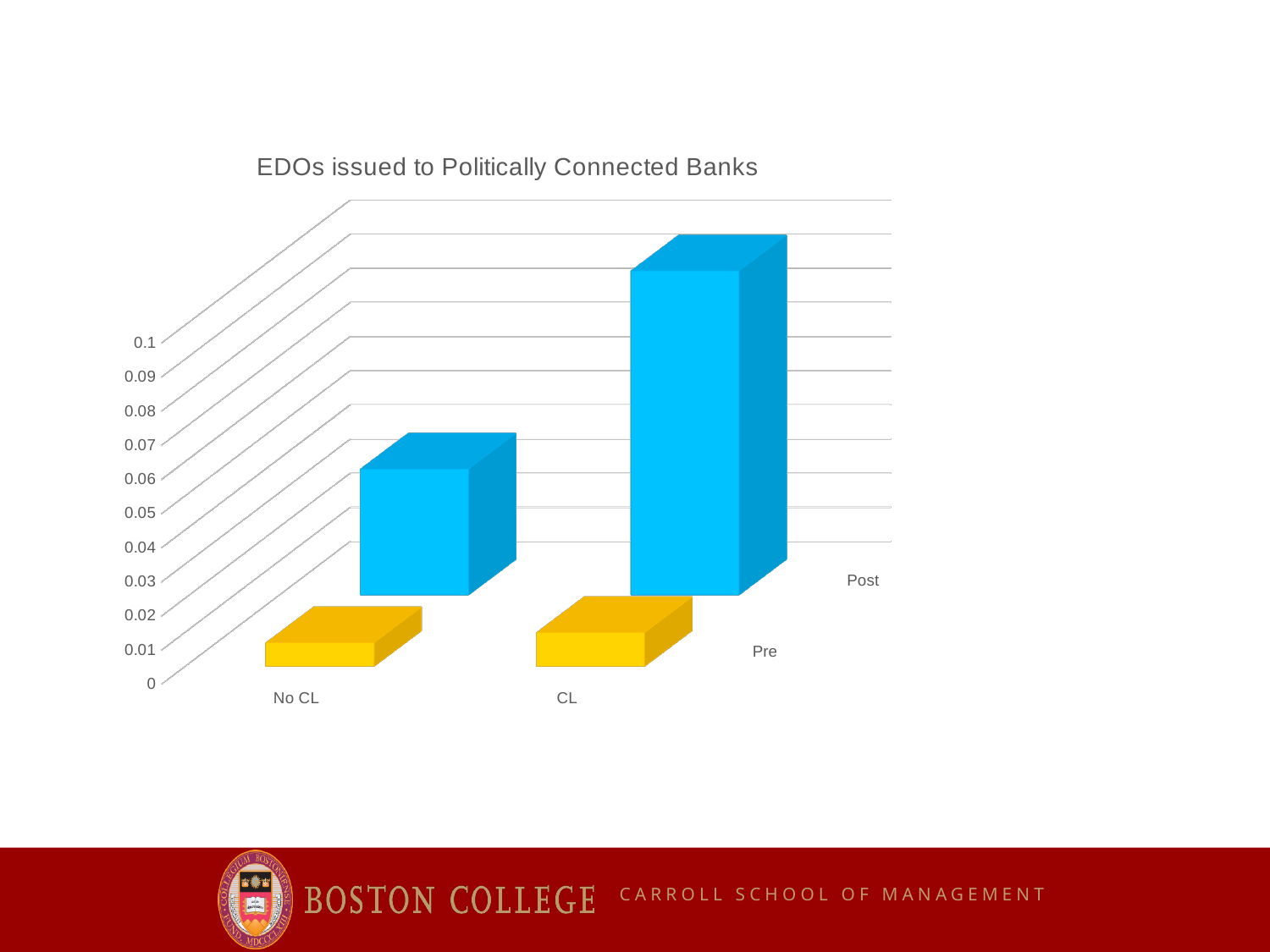
For the Post series, which is larger: No CL or CL? CL Is the Pre value for No CL greater or less than 0.03? less How many categories are shown on the x axis of the chart? 2 What kind of chart is shown on the slide? Bar chart For the No CL category, which is larger: Pre or Post? Post What is the title of the chart? EDOs issued to Politically Connected Banks Which series has the tallest bar in the chart? Post What are the two series shown in the chart? Pre and Post Does the Post series rise or fall from No CL to CL? Rise Which category has the tallest bar in the chart? CL Is the Post value for CL greater or less than 0.05? greater For the CL category, which is larger: Pre or Post? Post